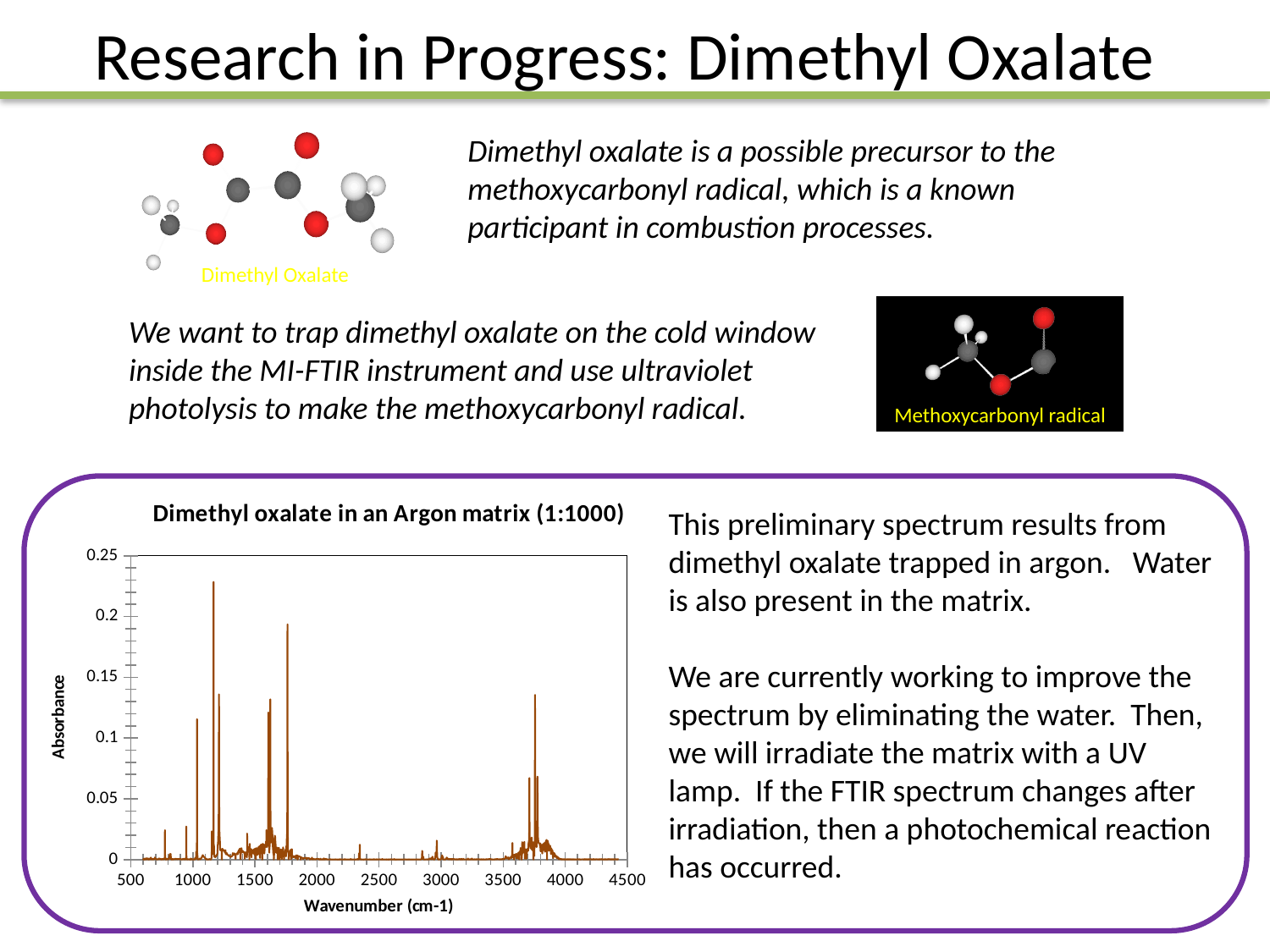
Is the absorbance of the peak near 1750 cm-1 greater or less than 0.15? greater What is the lowest wavenumber value labelled on the x axis of the chart? 500 What is the label of the x axis of the chart? Wavenumber (cm-1) Is the absorbance of the tallest peak in the spectrum greater or less than 0.2? greater What is the title of the chart? Dimethyl oxalate in an Argon matrix (1:1000) What kind of chart is shown on the slide? line chart Does the tallest peak in the spectrum occur between 1000 and 1500 cm-1 or between 3500 and 4000 cm-1? between 1000 and 1500 cm-1 Is the absorbance of the tallest peak near 3750 cm-1 greater or less than 0.15? less